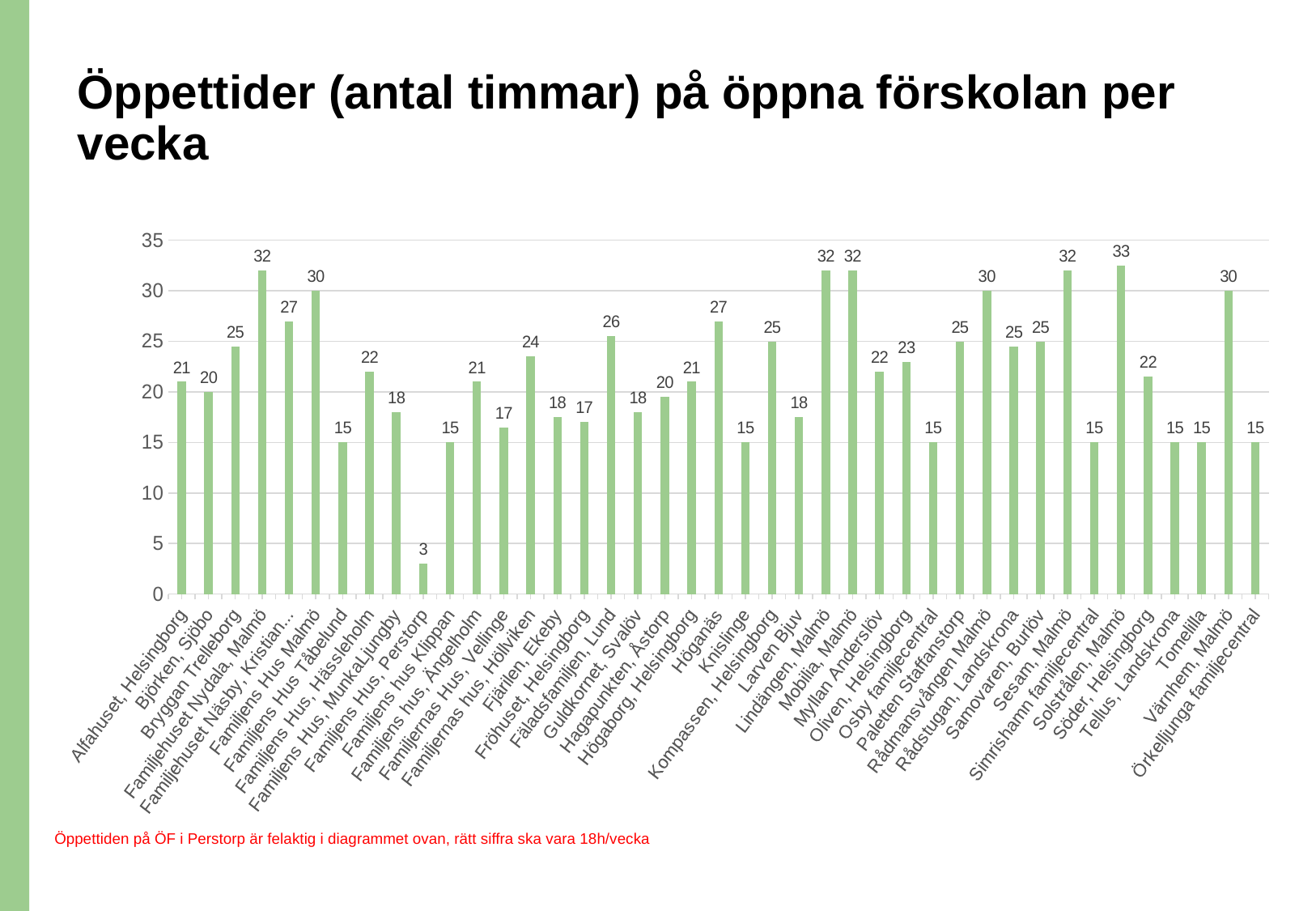
What type of chart is shown on the slide? bar chart How many open preschools (categories) are shown in the chart? 41 Which has a higher value, Höganäs or Kompassen, Helsingborg? Höganäs What is the difference between the values for Familjehuset Nydala, Malmö and Familjens Hus Tåbelund? 17 What is the title of the chart? Öppettider (antal timmar) på öppna förskolan per vecka What value is shown for Oliven, Helsingborg? 23 Is the value for Rådmansvången Malmö greater or less than 25? greater How many hours per week is shown for Solstrålen, Malmö? 33 What value is shown for Fäladsfamiljen, Lund? 26 Which open preschool has the lowest value plotted in the chart? Familjens Hus, Perstorp What value is shown for Familjens Hus, Perstorp in the chart? 3 Which open preschool has the highest number of opening hours per week in the chart? Solstrålen, Malmö